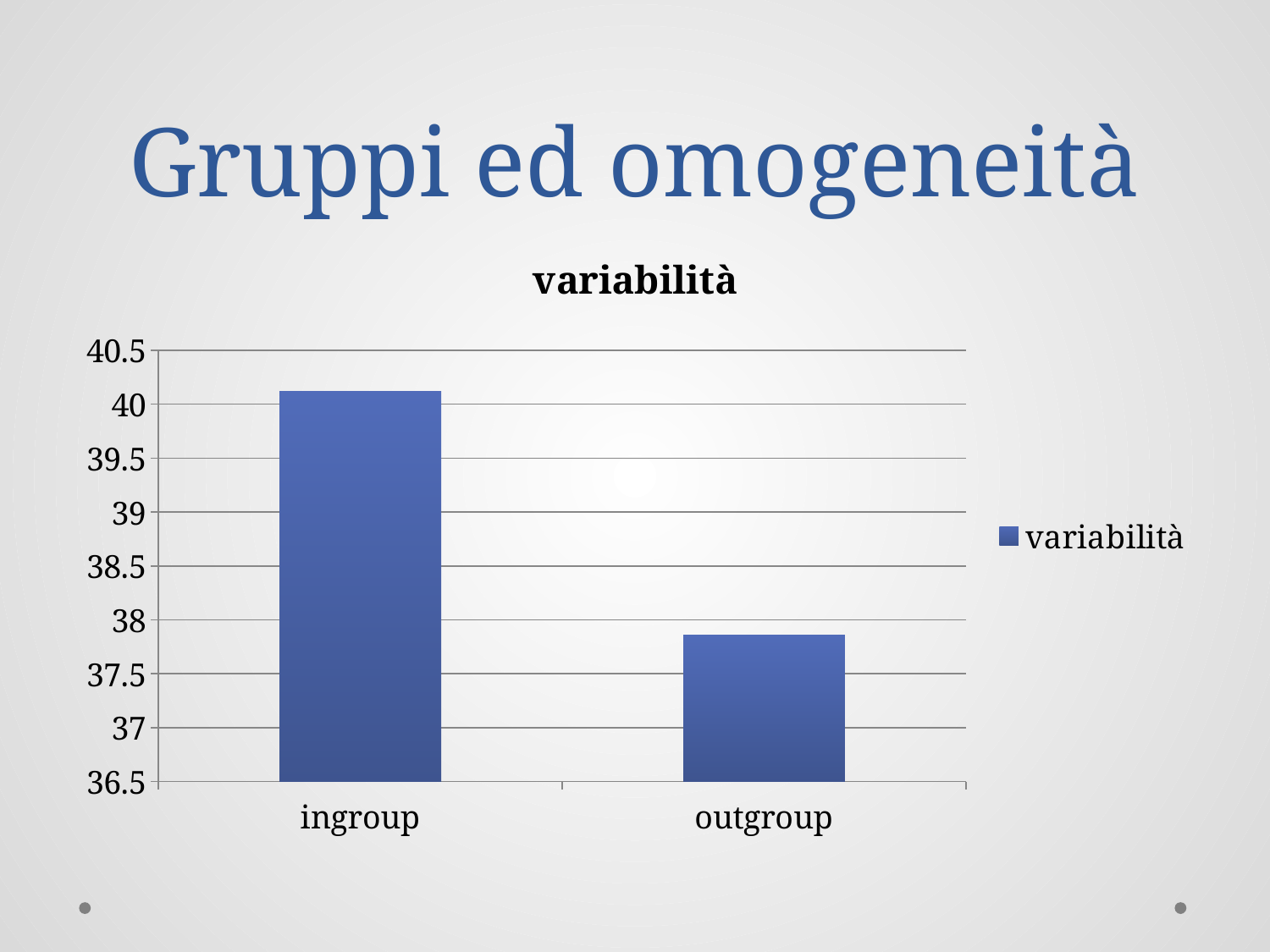
Which category has the lowest value? outgroup Is the value for outgroup greater or less than 37.5? greater How many categories are shown on the x axis of the chart? 2 What is the title of the chart? variabilità Is the value for ingroup greater or less than 40? greater What kind of chart is shown on the slide? bar chart How many series does the legend list? 1 Do the values rise or fall from ingroup to outgroup along the x axis? fall Is the value for outgroup greater or less than 38? less Which is larger, the value for ingroup or the value for outgroup? ingroup What is the name of the series shown in the legend? variabilità Which category has the highest value? ingroup